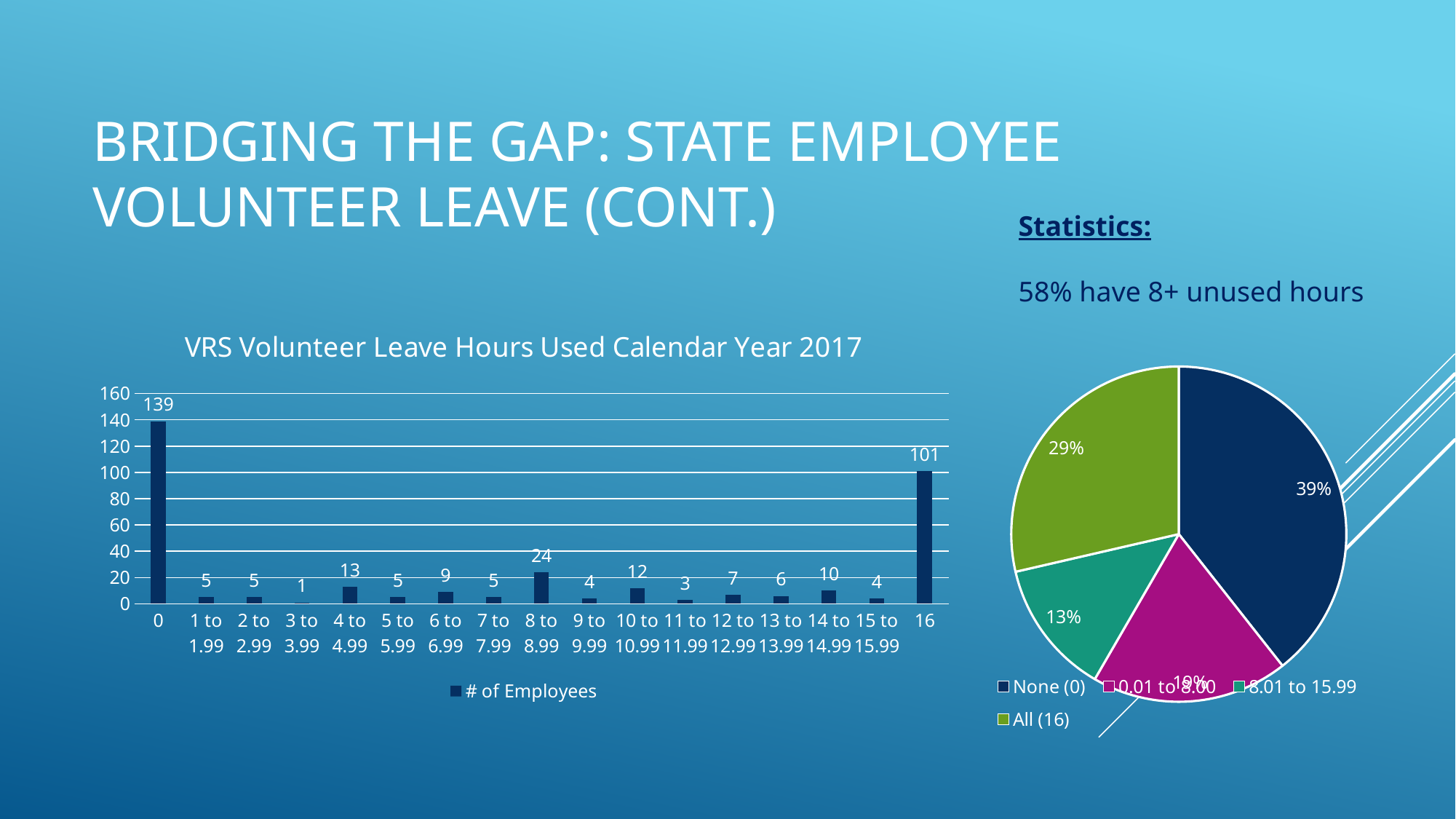
In the pie chart on the right of the slide, what share is labelled for the 'All (16)' slice? 29% How many entries does the legend of the pie chart on the right of the slide list? 4 How many categories are shown on the x axis of the bar chart titled 'VRS Volunteer Leave Hours Used Calendar Year 2017'? 17 In the bar chart titled 'VRS Volunteer Leave Hours Used Calendar Year 2017', which has more employees: '10 to 10.99' or '14 to 14.99'? 10 to 10.99 What type of chart is the 'VRS Volunteer Leave Hours Used Calendar Year 2017' chart? bar chart In the bar chart titled 'VRS Volunteer Leave Hours Used Calendar Year 2017', which category has the highest number of employees? 0 In the bar chart titled 'VRS Volunteer Leave Hours Used Calendar Year 2017', how many employees are in the '8 to 8.99' category? 24 In the bar chart titled 'VRS Volunteer Leave Hours Used Calendar Year 2017', what is the difference between the '0' category and the '16' category? 38 In the bar chart titled 'VRS Volunteer Leave Hours Used Calendar Year 2017', how many employees used 0 hours? 139 In the bar chart titled 'VRS Volunteer Leave Hours Used Calendar Year 2017', which category has the lowest number of employees? 3 to 3.99 In the bar chart titled 'VRS Volunteer Leave Hours Used Calendar Year 2017', what is the value for the '16' category? 101 In the pie chart on the right of the slide, what share is labelled for the 'None (0)' slice? 39%